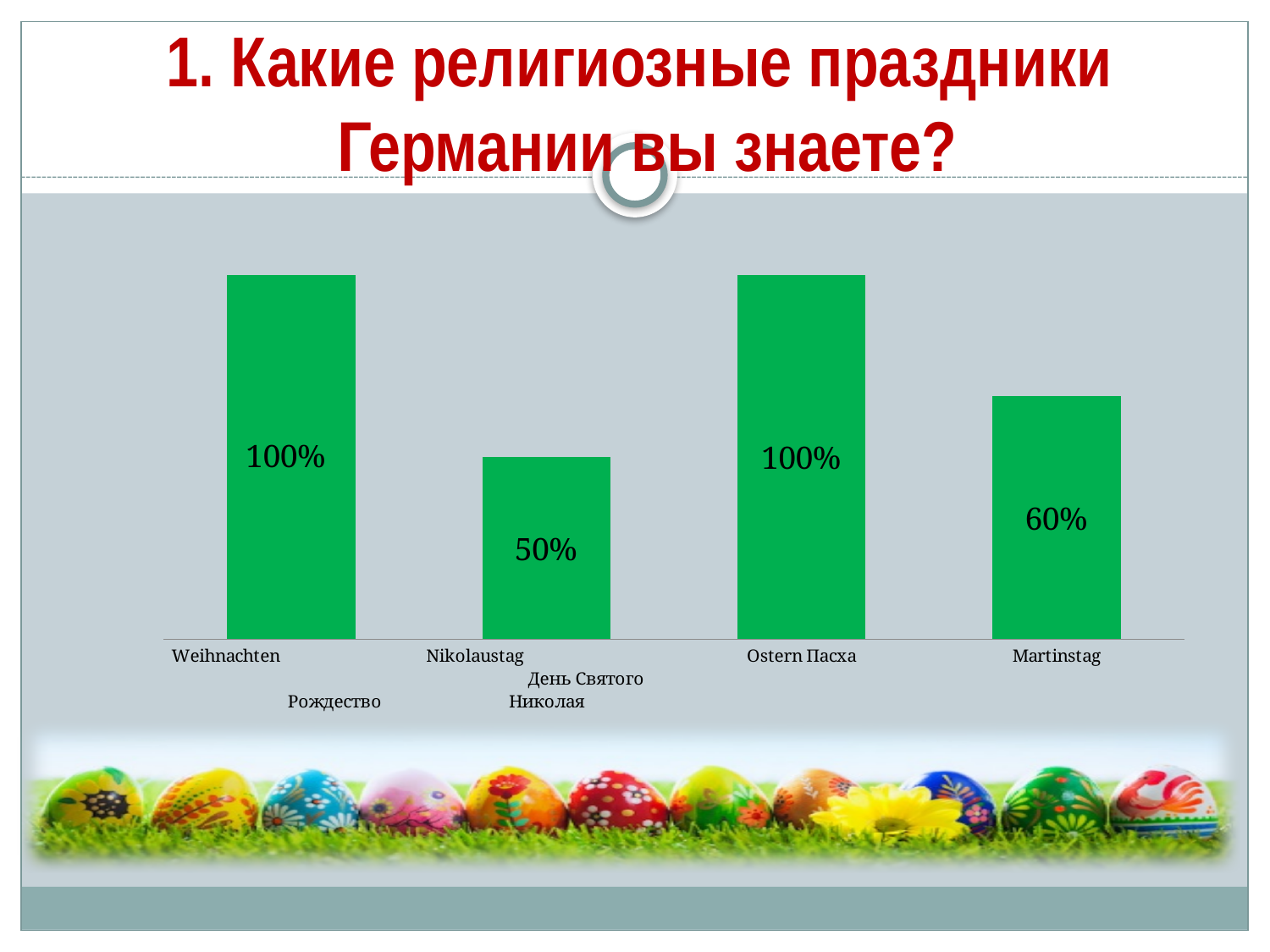
What is the value for Martinstag? 60% Which is larger, the value for Martinstag or the value for Nikolaustag? Martinstag What is the value for Nikolaustag? 50% Which category has the lowest value? Nikolaustag What colour are the bars in the chart? Green Which is larger, the value for Ostern or the value for Martinstag? Ostern What is the value for Ostern (Пасха)? 100% How many categories are shown in the chart? 4 What is the difference between the values for Weihnachten and Nikolaustag? 50% What kind of chart is shown on the slide? Bar chart What is the difference between the values for Martinstag and Nikolaustag? 10% What is the value for Weihnachten? 100%